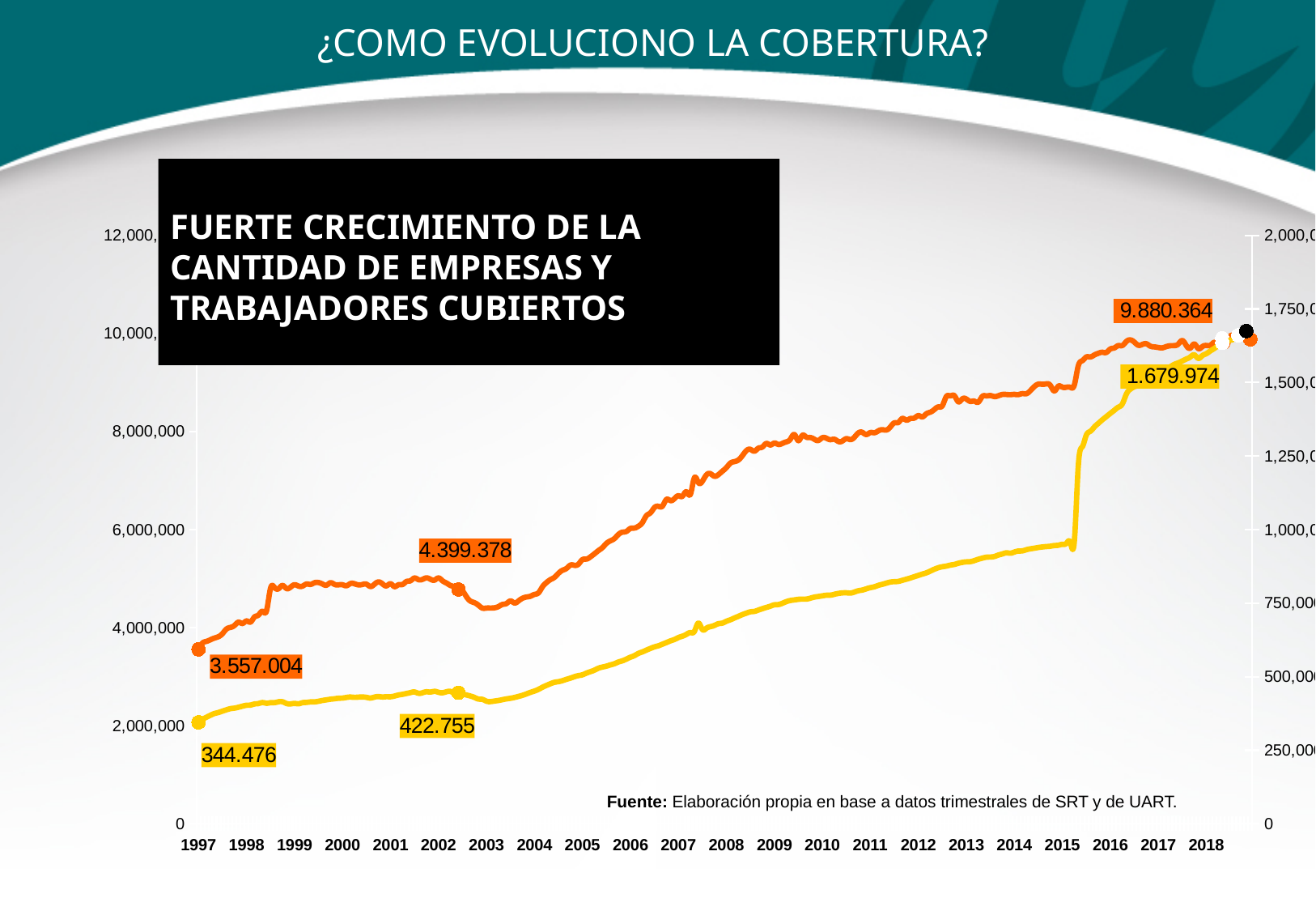
What is the value of the orange line's data label at the end of the series in 2018? 9.880.364 How many years are labeled on the x axis? 22 What is the value of the orange line's data label at the start of the series in 1997? 3.557.004 What kind of chart is shown on the slide? Line chart Is the value of the orange line in 2008 greater or less than 8,000,000 on the left axis? less What is the value of the yellow line's data label in 2018? 1.679.974 What is the value of the yellow line's data label in 1997? 344.476 What is the value of the yellow line's data label around 2002? 422.755 By how much did the orange line's labeled value increase from 1997 (3.557.004) to 2018 (9.880.364)? 6.323.360 By how much did the yellow line's labeled value increase from 1997 (344.476) to 2018 (1.679.974)? 1.335.498 What is the value of the orange line's data label around 2002? 4.399.378 Do the values of the orange line generally rise or fall from 1997 to 2018? Rise